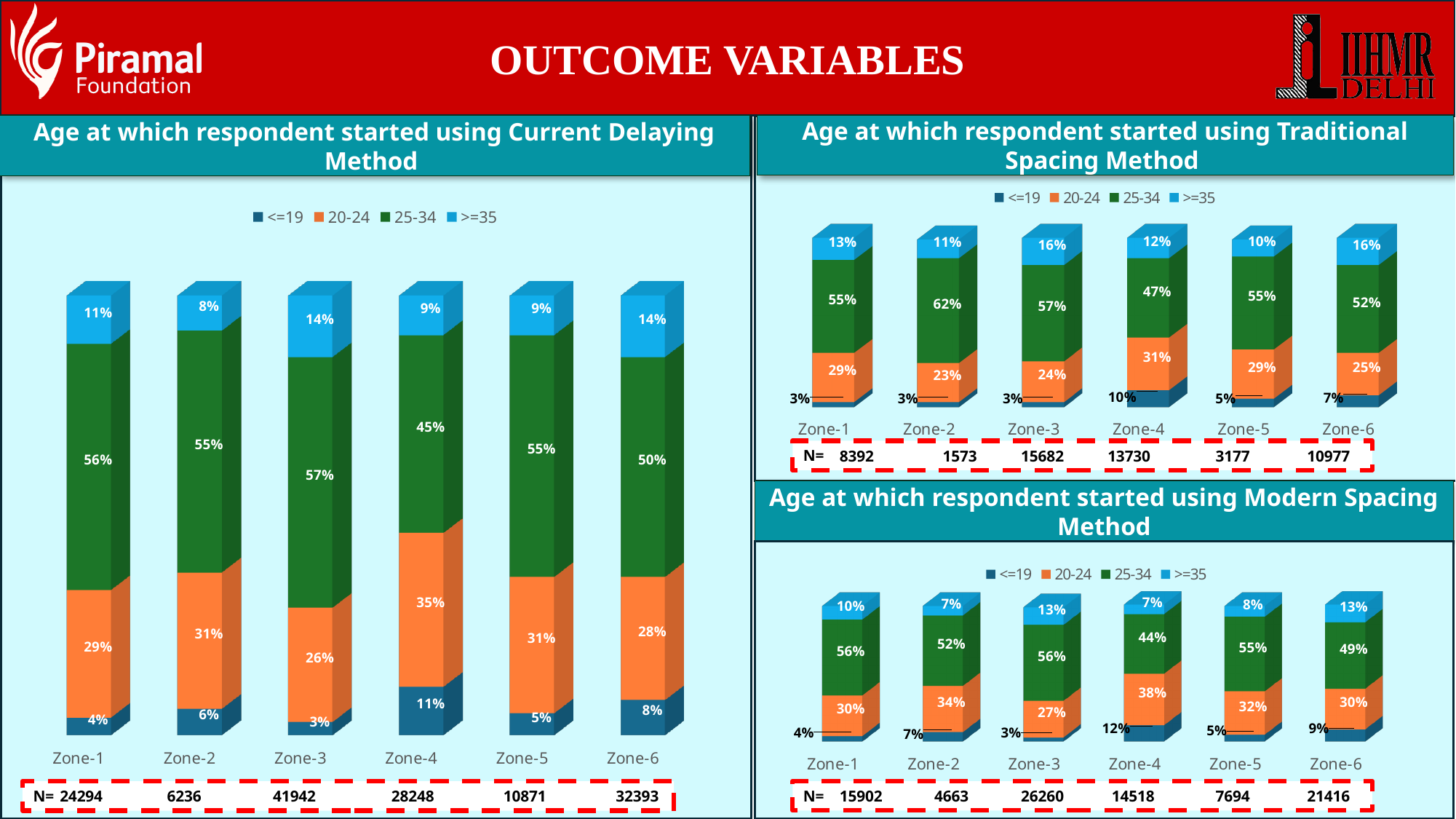
In the 'Age at which respondent started using Current Delaying Method' chart, which zone has the highest value for the <=19 series? Zone-4 In the 'Age at which respondent started using Traditional Spacing Method' chart, how many series does the legend list? 4 In the 'Age at which respondent started using Current Delaying Method' chart, how many zones are shown on the x axis? 6 In the 'Age at which respondent started using Traditional Spacing Method' chart, what is the value for the 25-34 series in Zone-2? 62% In the 'Age at which respondent started using Traditional Spacing Method' chart, which zone has the lowest value for the 25-34 series? Zone-4 In the 'Age at which respondent started using Traditional Spacing Method' chart, is the >=35 value larger for Zone-3 or Zone-5? Zone-3 What kind of chart is the 'Age at which respondent started using Modern Spacing Method' chart? Stacked bar chart In the 'Age at which respondent started using Current Delaying Method' chart, what is the difference between the 20-24 values for Zone-4 and Zone-3? 9% In the 'Age at which respondent started using Modern Spacing Method' chart, which zone has the highest value for the >=35 series? Zone-3 and Zone-6 (tied at 13%) In the 'Age at which respondent started using Modern Spacing Method' chart, what is the value for the 20-24 series in Zone-4? 38% In the 'Age at which respondent started using Current Delaying Method' chart, what is the value for the 25-34 series in Zone-3? 57% In the 'Age at which respondent started using Modern Spacing Method' chart, what is the difference between the 25-34 values for Zone-1 and Zone-6? 7%